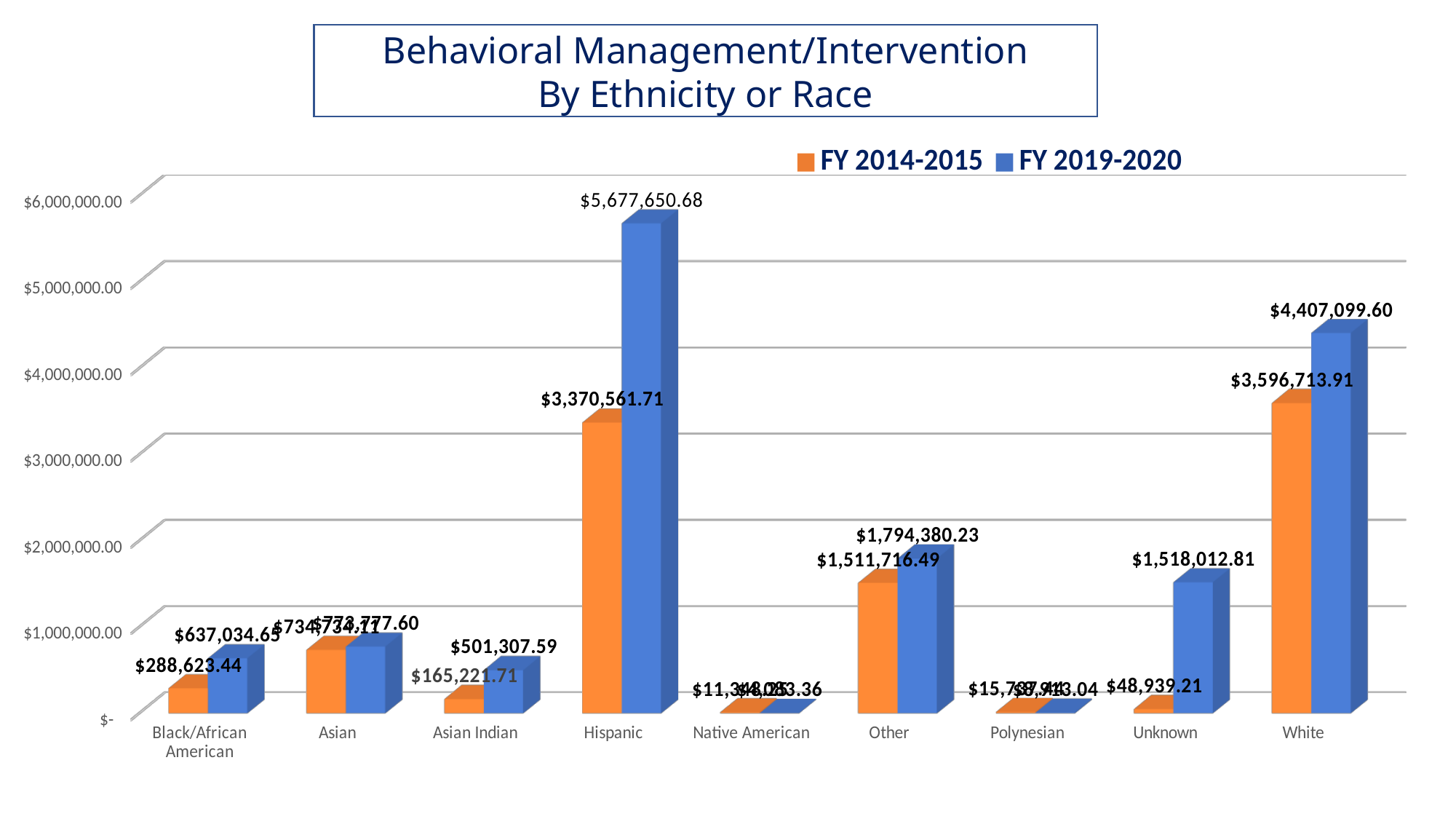
What is the difference between the FY 2019-2020 and FY 2014-2015 values for Hispanic? $2,307,088.97 Which category has the highest FY 2019-2020 value? Hispanic Which is larger for Other: the FY 2014-2015 value or the FY 2019-2020 value? FY 2019-2020 How many series does the legend list? 2 How many ethnicity or race categories are shown on the x axis? 9 What is the FY 2014-2015 value for Asian Indian? $165,221.71 Which category has the highest FY 2014-2015 value? White What is the FY 2019-2020 value for Hispanic? $5,677,650.68 Is the FY 2019-2020 value for White greater or less than $4,000,000.00? greater What is the FY 2014-2015 value for White? $3,596,713.91 What is the FY 2019-2020 value for Unknown? $1,518,012.81 What type of chart is shown on the slide? Bar chart